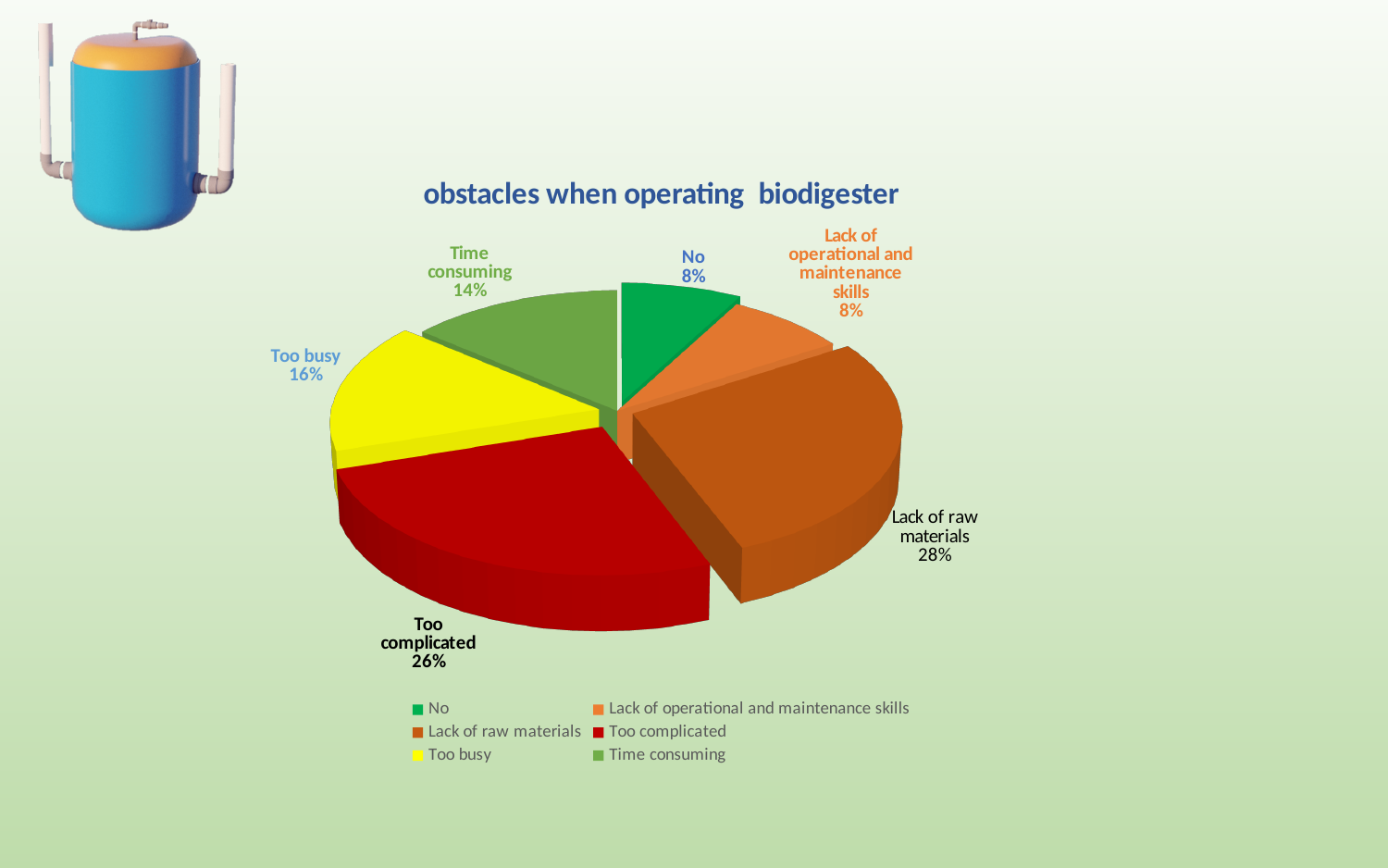
What share of the pie is 'Lack of operational and maintenance skills'? 8% What is the difference between the shares for 'Lack of raw materials' and 'Too busy'? 12% What share of the pie is 'Time consuming'? 14% Which is larger, the share for 'Too busy' or the share for 'Time consuming'? Too busy What share of the pie is 'Too busy'? 16% What colour is the 'Too complicated' slice? Red What is the title of the chart? obstacles when operating biodigester Which category has the largest share of the pie? Lack of raw materials What kind of chart is shown on the slide? Pie chart How many categories does the pie chart have? 6